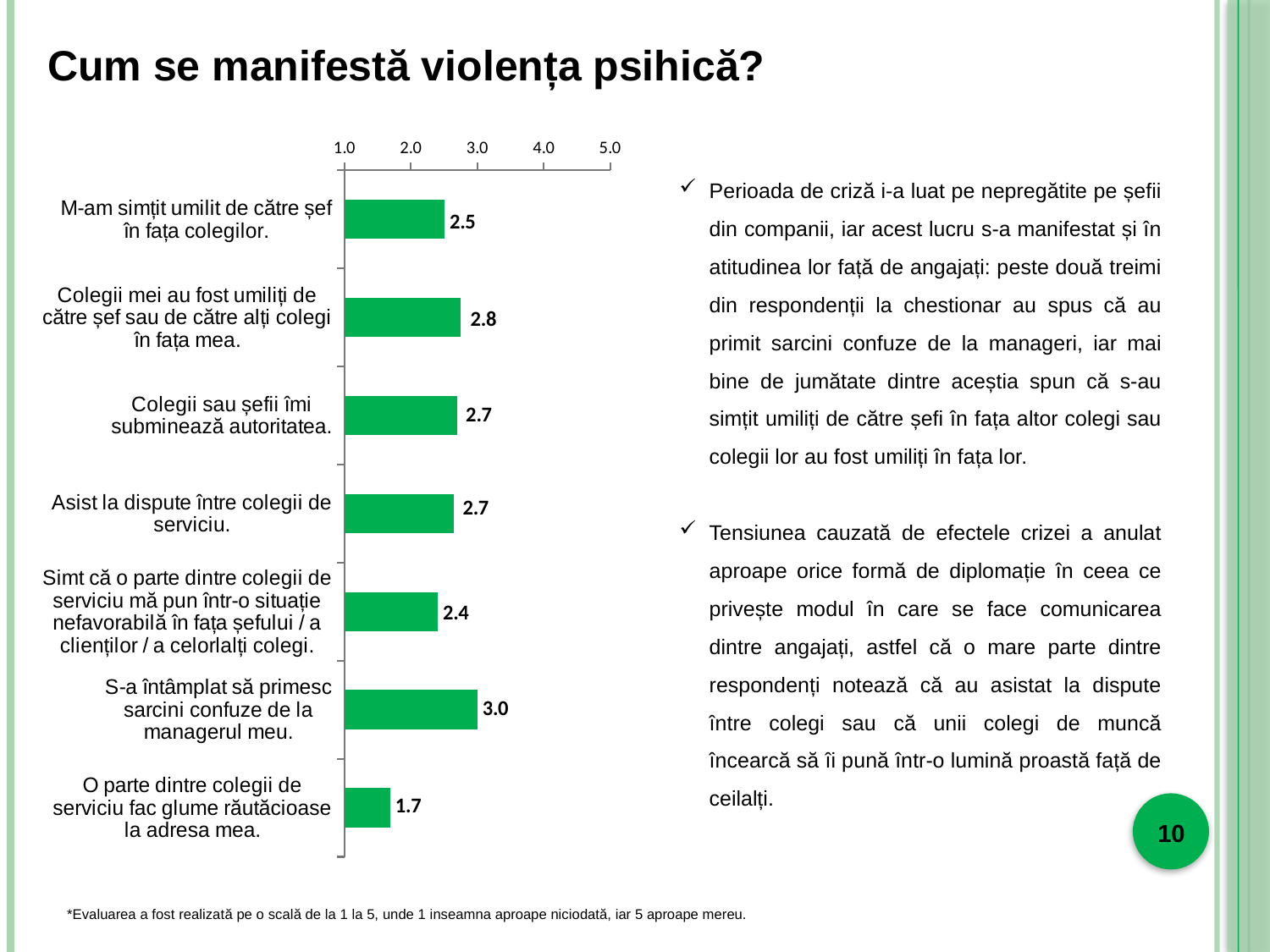
What is the title of the slide containing the chart? Cum se manifestă violența psihică? What is the value for "M-am simțit umilit de către șef în fața colegilor."? 2.5 Which category has the lowest value? O parte dintre colegii de serviciu fac glume răutăcioase la adresa mea. Which category has the highest value? S-a întâmplat să primesc sarcini confuze de la managerul meu. Is the value for "Simt că o parte dintre colegii de serviciu mă pun într-o situație nefavorabilă în fața șefului / a clienților / a celorlalți colegi." greater or less than 3.0? less What is the value for "O parte dintre colegii de serviciu fac glume răutăcioase la adresa mea."? 1.7 What is the value for "S-a întâmplat să primesc sarcini confuze de la managerul meu."? 3.0 What is the difference between the value for "S-a întâmplat să primesc sarcini confuze de la managerul meu." and the value for "O parte dintre colegii de serviciu fac glume răutăcioase la adresa mea."? 1.3 What kind of chart is shown on the slide? bar chart Which is larger: the value for "Colegii mei au fost umiliți de către șef sau de către alți colegi în fața mea." or the value for "M-am simțit umilit de către șef în fața colegilor."? Colegii mei au fost umiliți de către șef sau de către alți colegi în fața mea. How many categories are shown in the chart? 7 What is the value for "Colegii sau șefii îmi subminează autoritatea."? 2.7